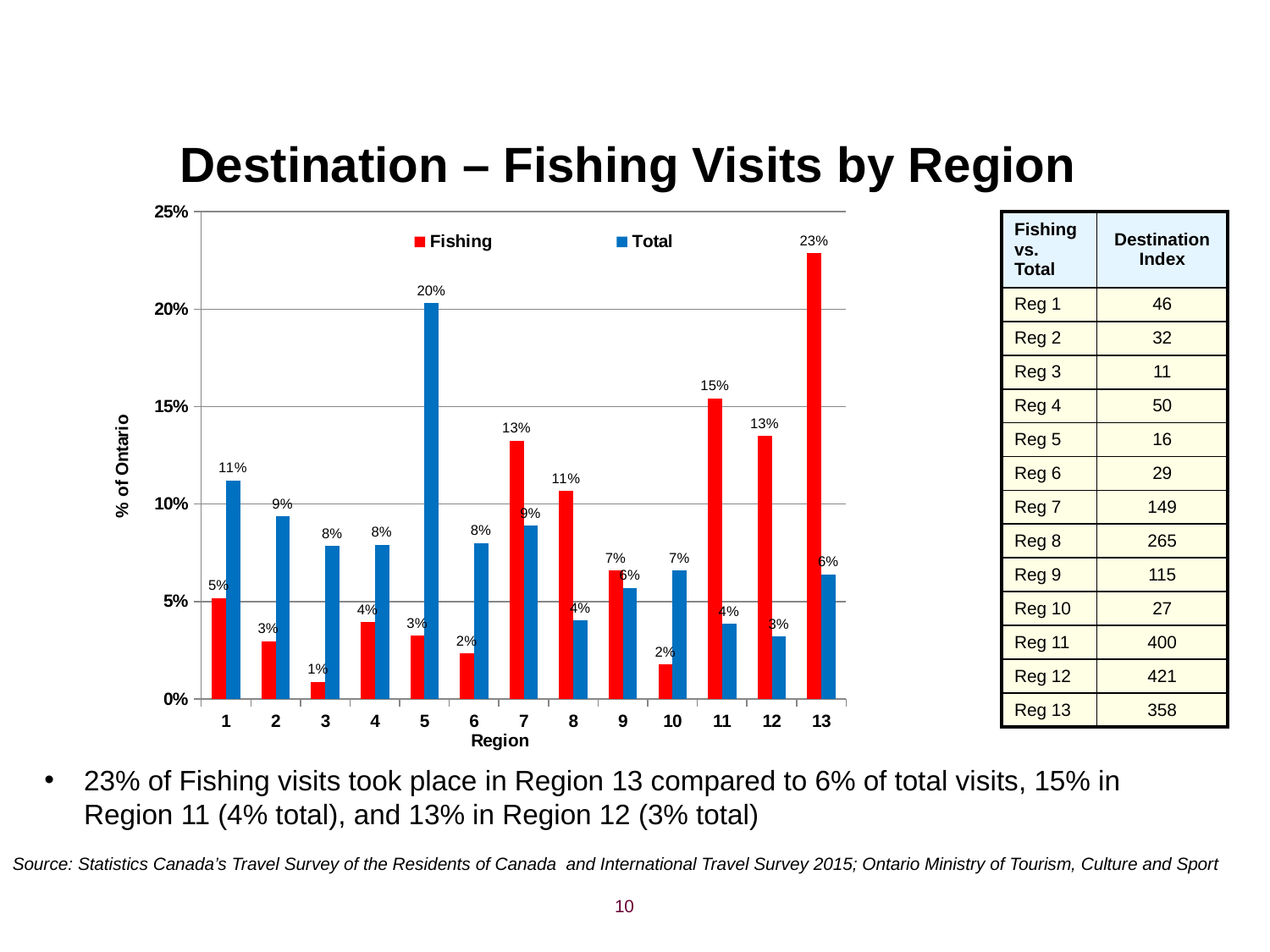
Which region has the lowest Fishing value? 3 Which region has the highest Fishing value? 13 What is the Total value for Region 1? 11% Which region has the highest Total value? 5 What is the difference between the Fishing and Total values for Region 13? 17% How many series does the legend list? 2 How many regions are shown on the x axis? 13 What is the Fishing value for Region 13? 23% What is the Fishing value for Region 11? 15% What type of chart is shown on the slide? Bar chart For Region 5, which is larger: the Fishing value or the Total value? Total What is the Total value for Region 5? 20%